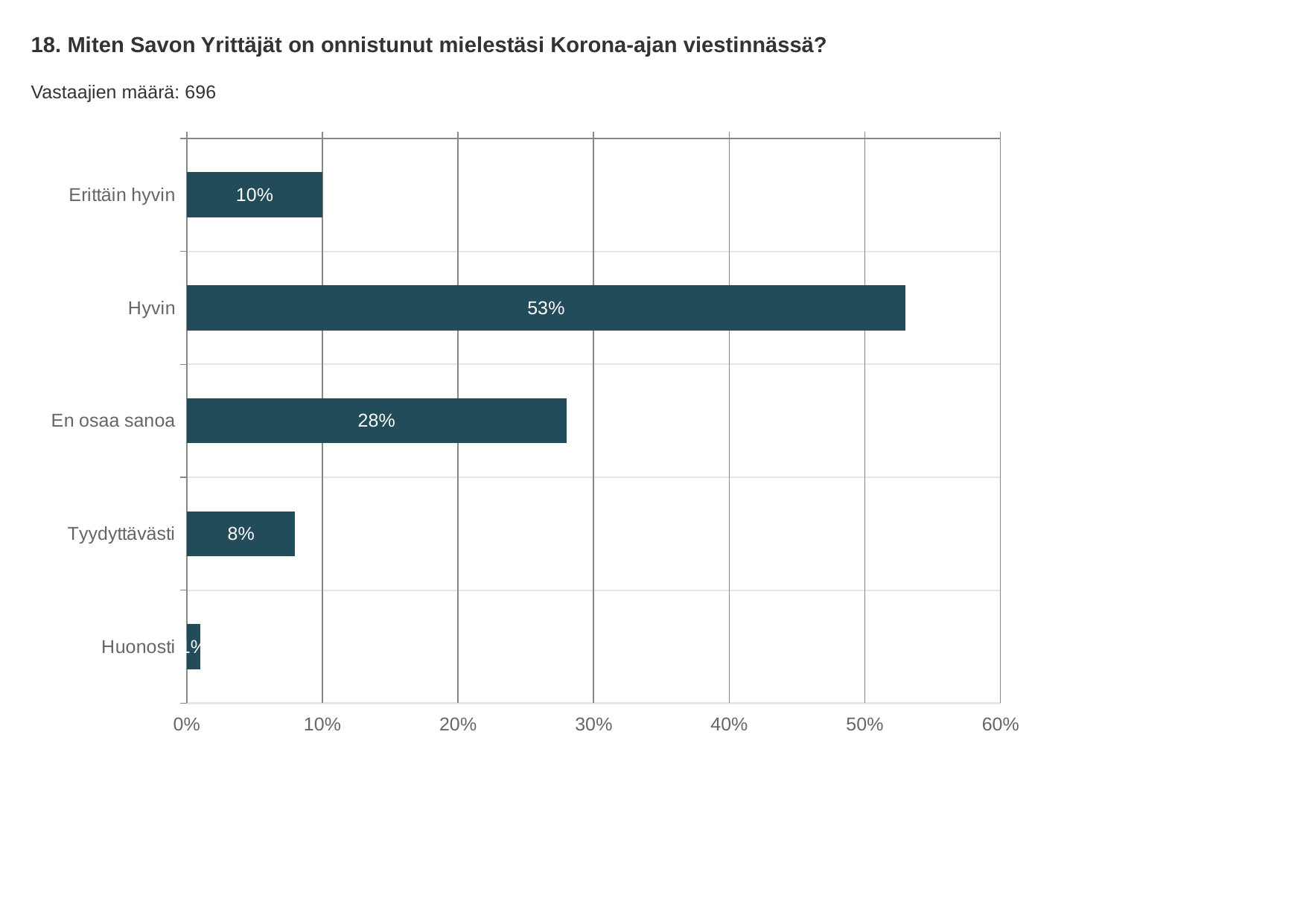
What is the value for Erittäin hyvin? 10% What is the value for En osaa sanoa? 28% What kind of chart is shown on the slide? bar chart What is the value for Hyvin? 53% How many categories are shown in the chart? 5 What is the value for Tyydyttävästi? 8% Which is larger, the value for Erittäin hyvin or the value for Tyydyttävästi? Erittäin hyvin How many respondents (Vastaajien määrä) are reported on the slide? 696 Which category has the lowest value? Huonosti Which category has the highest value? Hyvin Is the value for Huonosti greater or less than 10%? less What is the difference between the values for Hyvin and En osaa sanoa? 25%